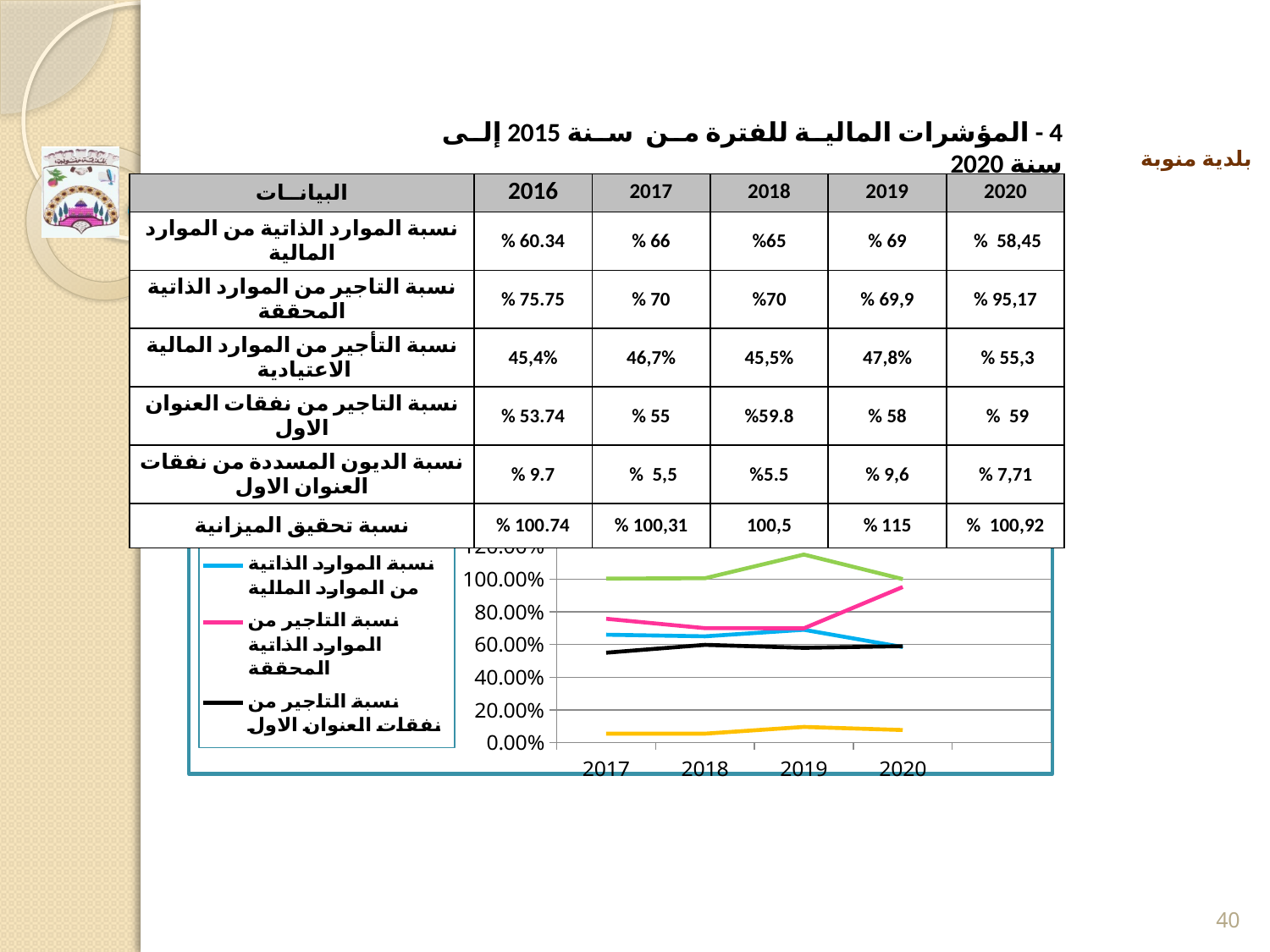
In the line chart, which year has the highest value for the pink line (نسبة التاجير من الموارد الذاتية المحققة)? 2020 In the line chart, does the pink line (نسبة التاجير من الموارد الذاتية المحققة) rise or fall from 2018 to 2020? rise In the line chart, is the value of the black line (نسبة التاجير من نفقات العنوان الاول) for 2017 greater or less than 60.00%? less In the line chart, does the green line rise or fall from 2019 to 2020? fall In the line chart, is the value of the green line for 2019 greater or less than 100.00%? greater In the line chart, at 2020, which is larger: the pink line or the blue line? the pink line In the line chart, is the value of the pink line (نسبة التاجير من الموارد الذاتية المحققة) for 2020 greater or less than 80.00%? greater According to the table above the chart, what is the value of نسبة تحقيق الميزانية for 2019? % 115 How many year labels are shown on the x axis of the line chart? 4 In the legend of the line chart, which series is drawn in blue? نسبة الموارد الذاتية من الموارد المالية What kind of chart is shown at the bottom of the slide? line chart